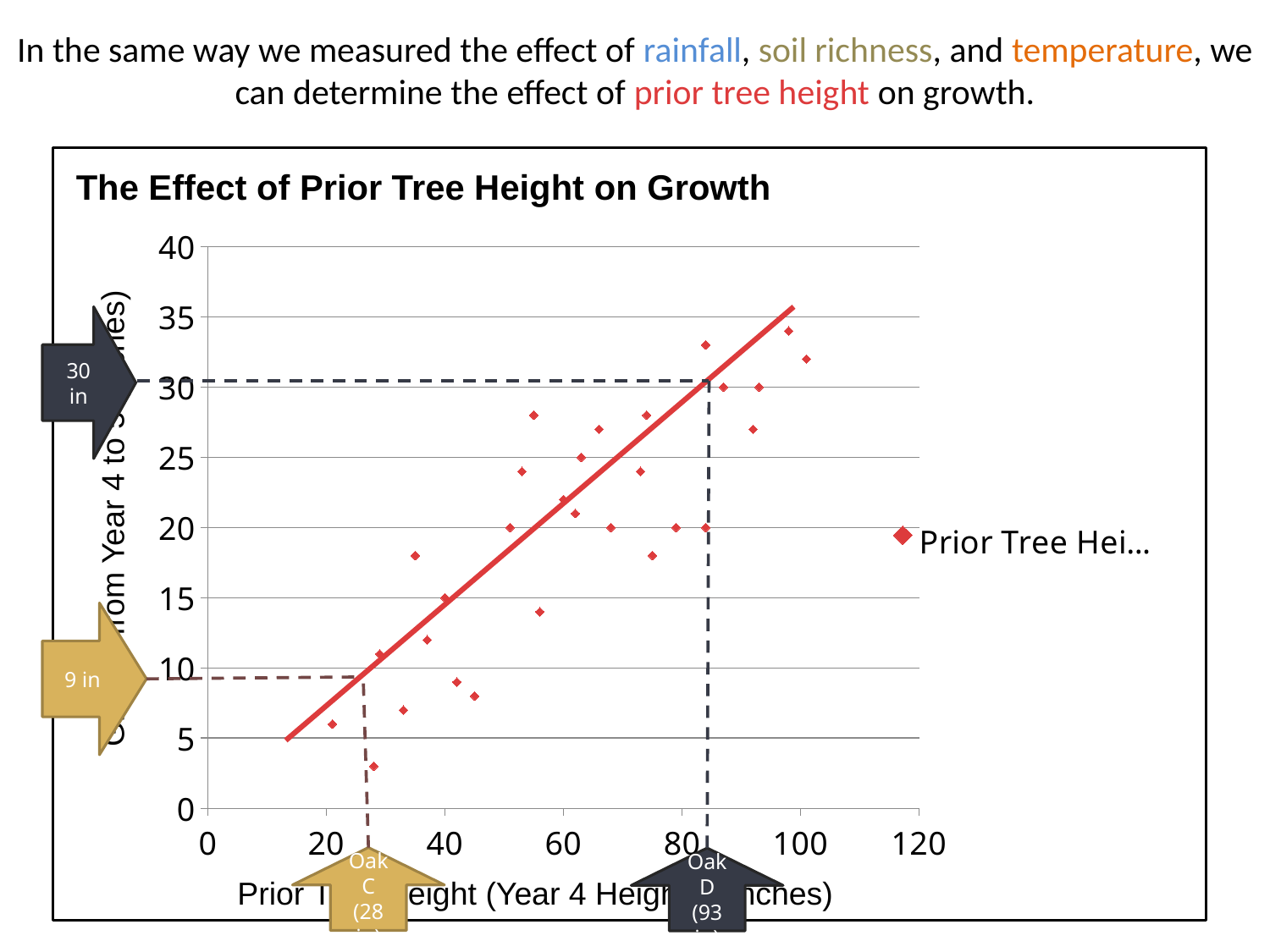
What is the highest value shown on the y axis? 40 Is the growth value of the highest plotted point greater or less than 30? greater What is the highest tick value shown on the x axis? 120 Which annotated tree has the larger predicted growth, Oak C or Oak D? Oak D According to the annotation, what growth does the trend line give for Oak D (93 in)? 30 in What kind of chart is shown on the slide? scatter chart Is the growth value of the lowest plotted point greater or less than 5? less According to the annotation, what growth does the trend line give for Oak C (28 in)? 9 in Do the plotted growth values generally rise or fall as prior tree height increases along the x axis? rise How many series does the chart's legend list? 1 What is the difference between the annotated growth values for Oak D and Oak C? 21 in What is the title of the chart? The Effect of Prior Tree Height on Growth